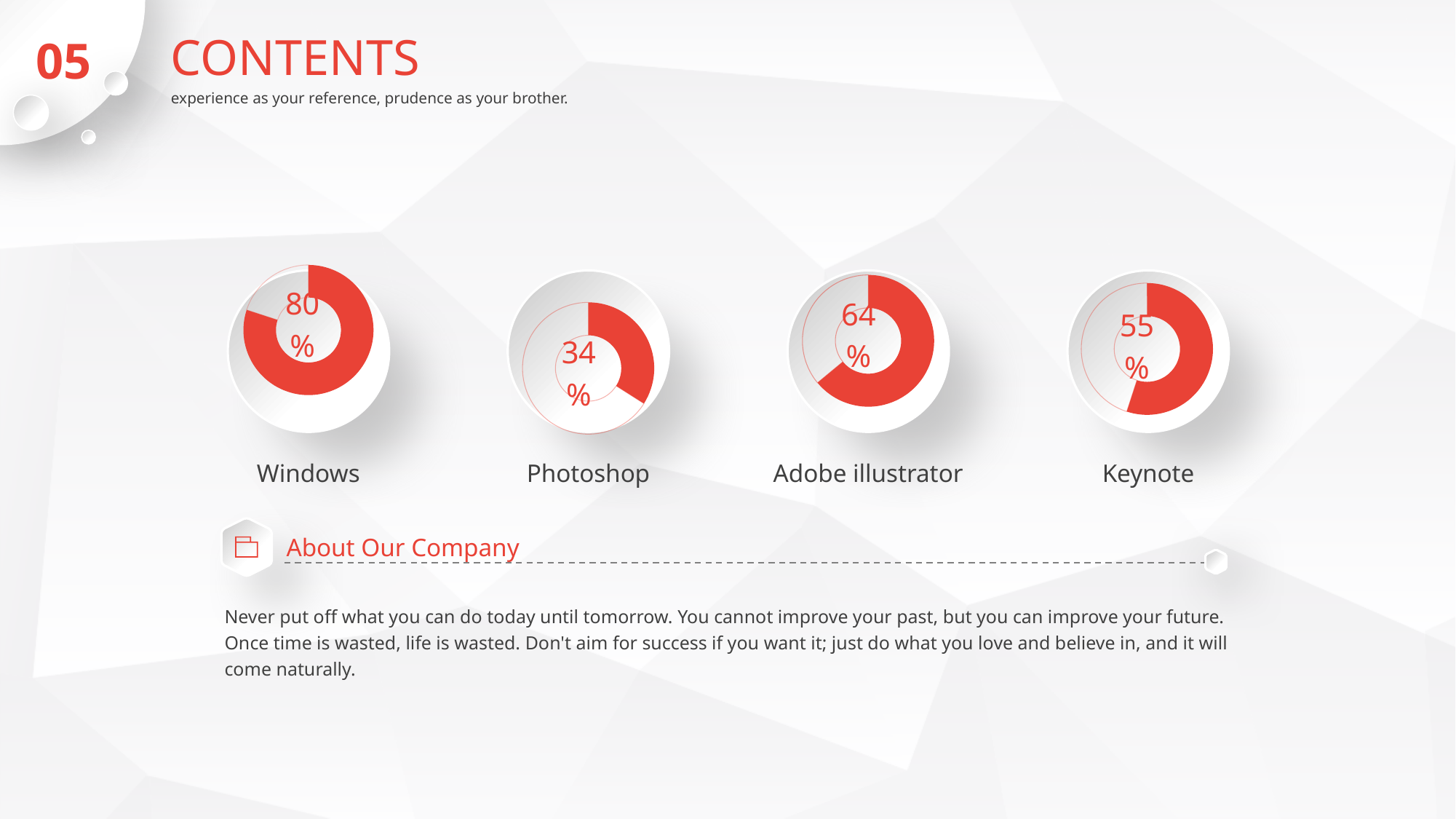
Which is larger, the Keynote value or the Adobe illustrator value? Adobe illustrator What colour is the filled portion of each donut chart? Red What is the difference between the Windows value and the Photoshop value? 46% What value is shown on the Adobe illustrator donut chart? 64% What value is shown on the Keynote donut chart? 55% What is the difference between the Adobe illustrator value and the Keynote value? 9% Across the four donut charts, which one shows the lowest percentage? Photoshop Across the four donut charts, which one shows the highest percentage? Windows What kind of chart is used to show the Windows value? Donut chart What value is shown on the Photoshop donut chart? 34% How many donut charts are shown on the slide? 4 What value is shown on the Windows donut chart? 80%